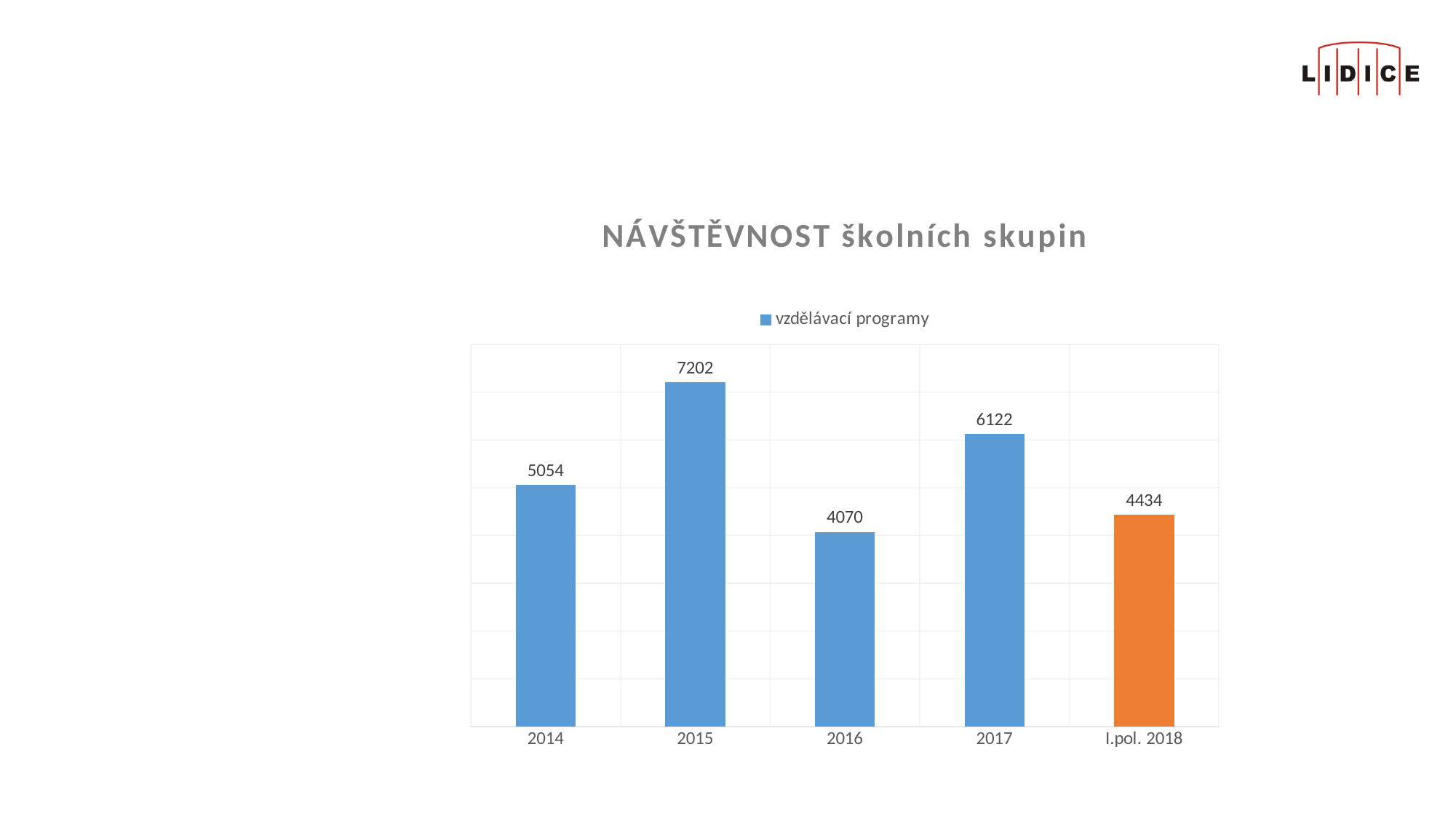
How many categories are shown on the x axis? 5 What is the value for 2015? 7202 Which category has the lowest value? 2016 How many series does the legend list? 1 What is the value for 2016? 4070 What is the difference between the values for 2017 and 2016? 2052 What is the difference between the values for 2015 and 2014? 2148 What is the value for I.pol. 2018? 4434 Which is larger, the value for 2014 or the value for I.pol. 2018? 2014 Which category has the highest value? 2015 What is the title of the chart? NÁVŠTĚVNOST školních skupin What kind of chart is shown? bar chart